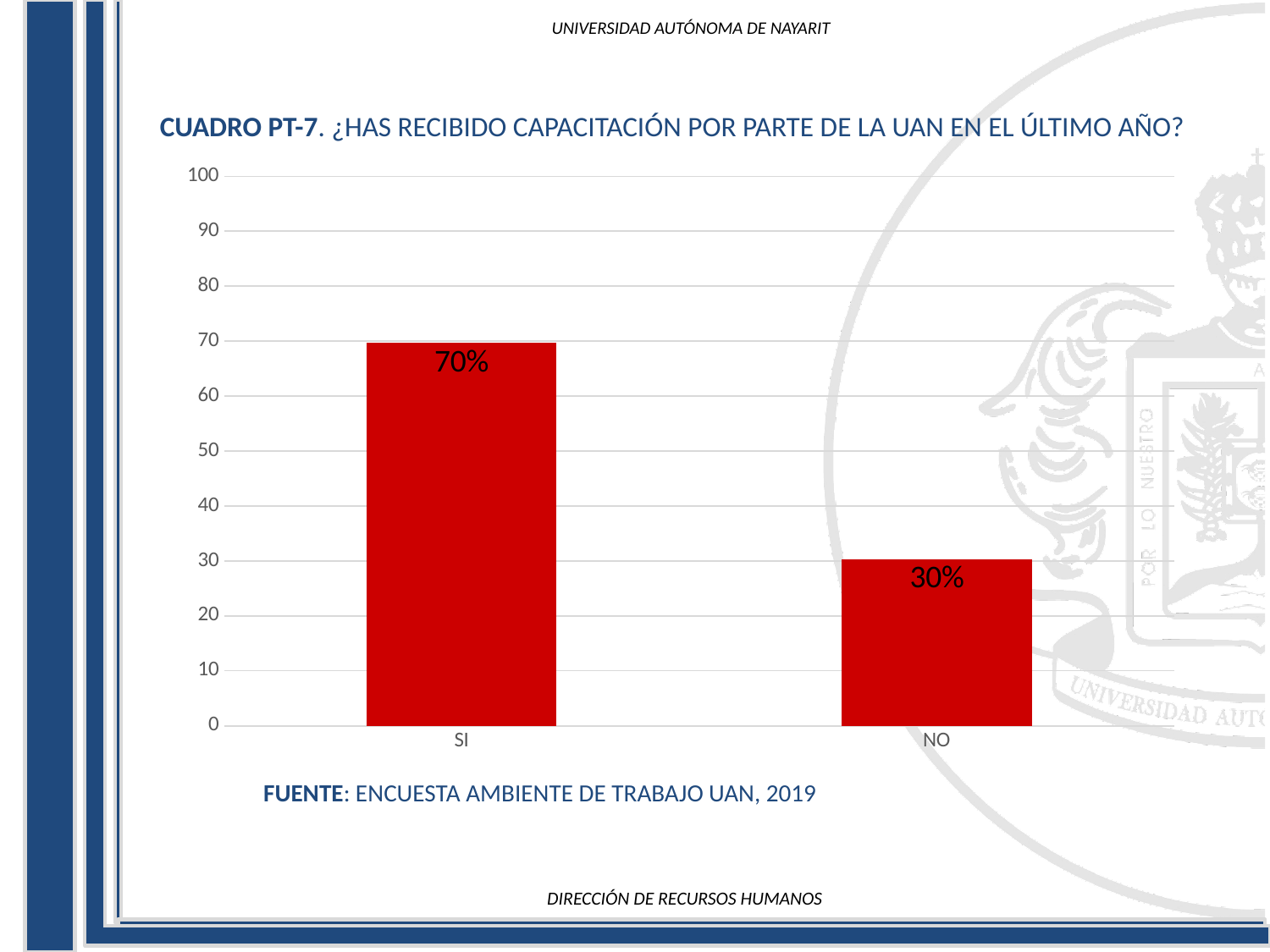
Is the value for SI greater or less than 50? greater What colour are the bars in the chart? red How many categories are shown on the x axis? 2 What is the value for NO? 30% Is the value for NO greater or less than 40? less Which category has the lowest value? NO Which is larger, the value for SI or the value for NO? SI What is the difference between the values for SI and NO? 40% What kind of chart is shown on the slide? bar chart Which category has the highest value? SI What is the source cited below the chart? ENCUESTA AMBIENTE DE TRABAJO UAN, 2019 What is the value for SI? 70%